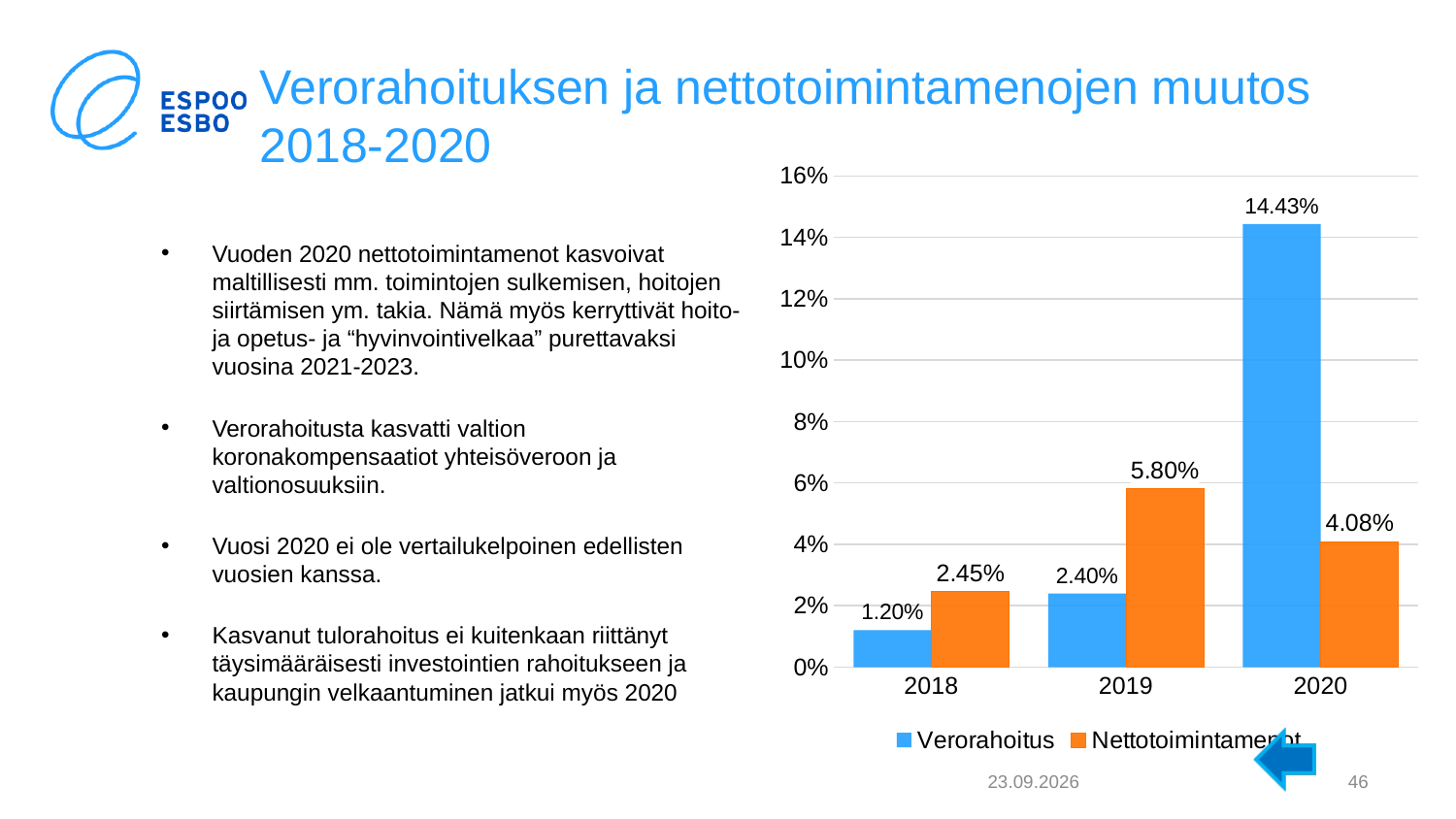
What is the difference between the Nettotoimintamenot and Verorahoitus values in 2019? 3.40 percentage points How many years are shown on the x axis? 3 What is the Verorahoitus value for 2020? 14.43% What is the difference between the Verorahoitus and Nettotoimintamenot values in 2020? 10.35 percentage points What is the Verorahoitus value for 2018? 1.20% What kind of chart is shown on the slide? Bar chart In which year is the Nettotoimintamenot value lowest? 2018 What is the Nettotoimintamenot value for 2020? 4.08% What is the Nettotoimintamenot value for 2019? 5.80% Which is larger in 2018, Verorahoitus or Nettotoimintamenot? Nettotoimintamenot In which year is the Verorahoitus value highest? 2020 How many series does the legend list? 2